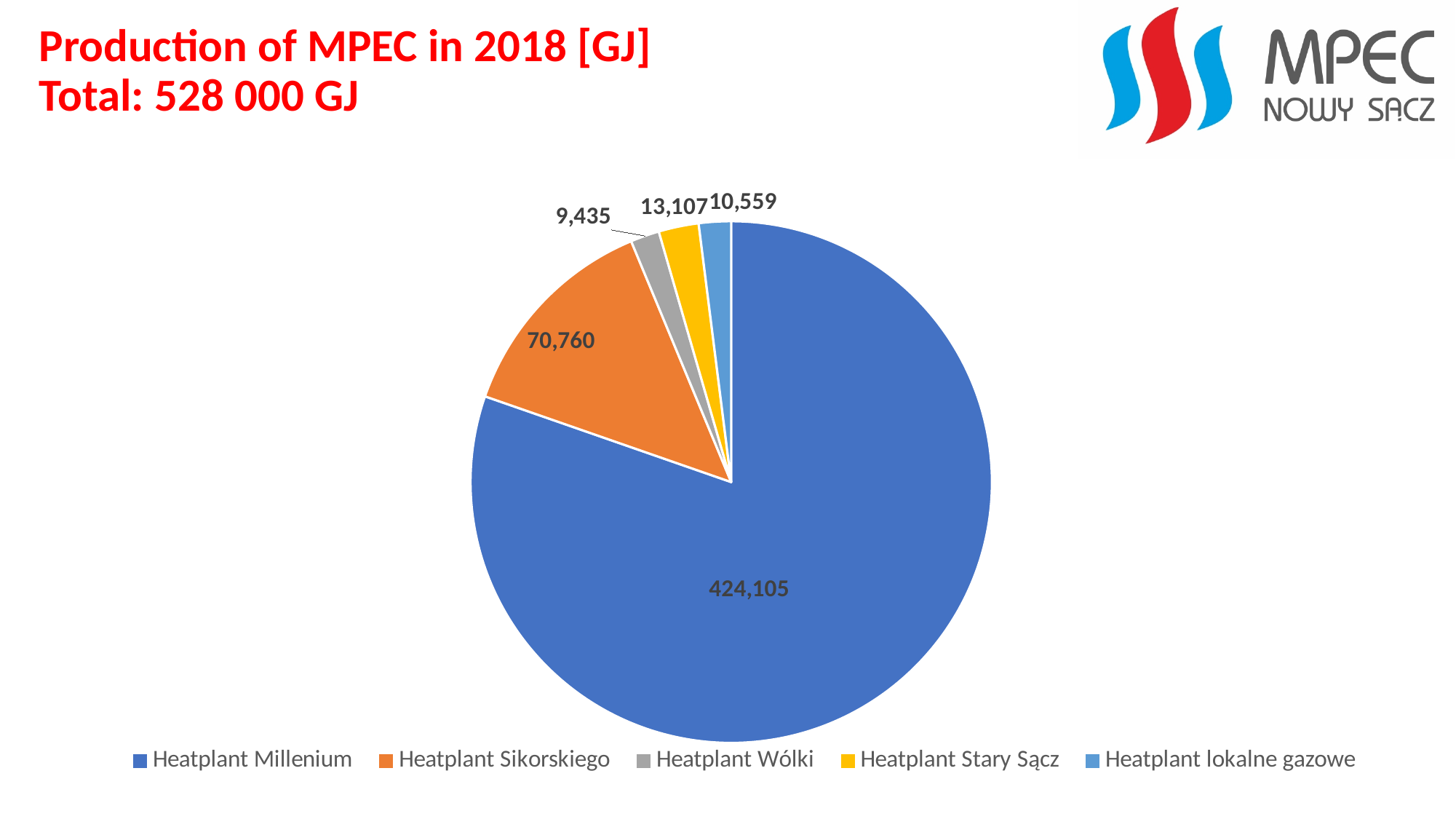
What is the production value for Heatplant lokalne gazowe? 10,559 What is the difference between the production of Heatplant Stary Sącz and Heatplant lokalne gazowe? 2,548 Which heatplant has the lowest production? Heatplant Wólki What is the difference between the production of Heatplant Sikorskiego and Heatplant Wólki? 61,325 What is the production value for Heatplant Sikorskiego? 70,760 Which heatplant has the highest production? Heatplant Millenium Which is larger, the production of Heatplant Stary Sącz or Heatplant lokalne gazowe? Heatplant Stary Sącz What is the production value for Heatplant Millenium? 424,105 What is the production value for Heatplant Stary Sącz? 13,107 How many heatplants are shown in the pie chart? 5 What kind of chart is shown on the slide? Pie chart What is the production value for Heatplant Wólki? 9,435